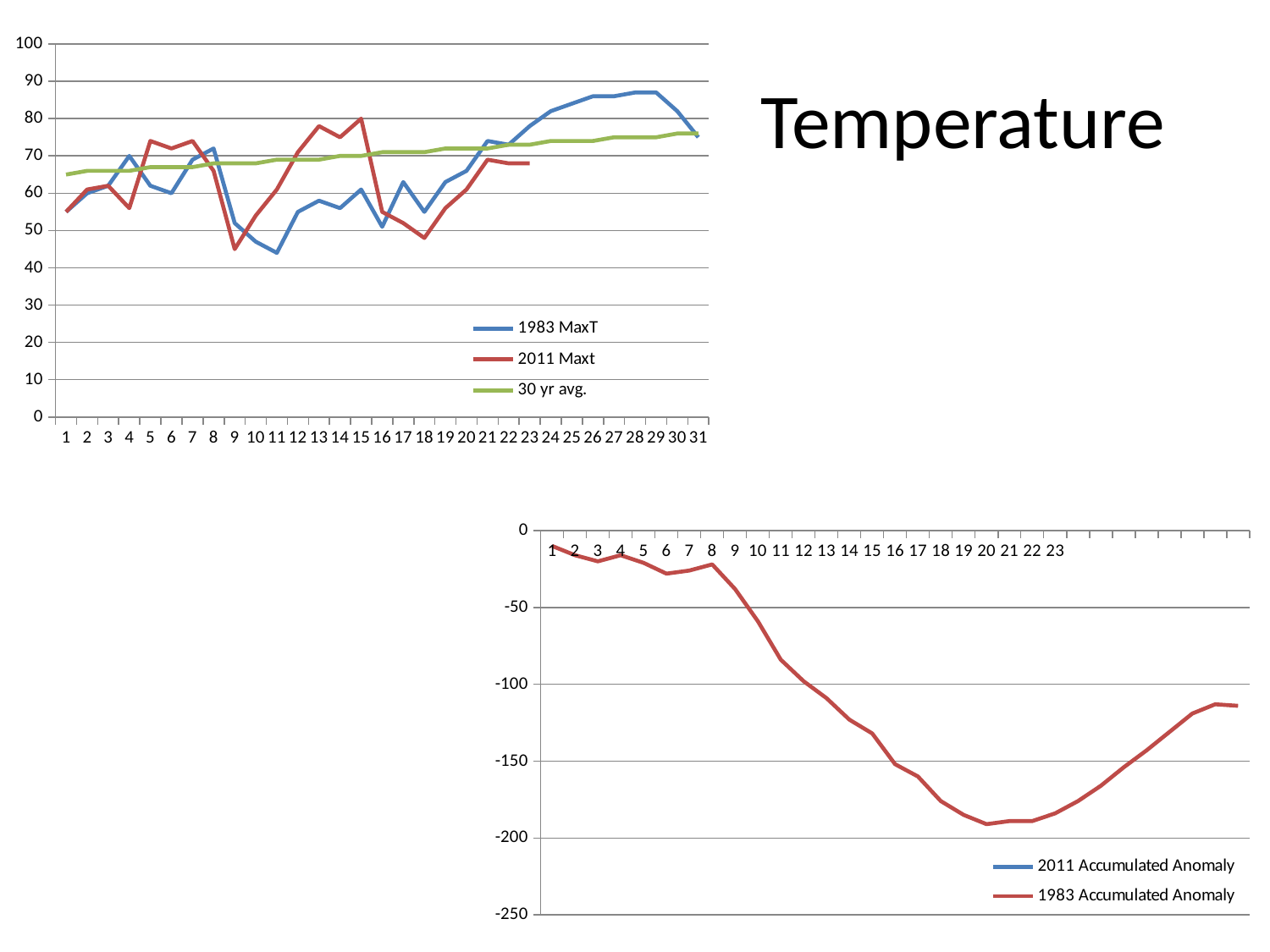
In the top-left chart, at point 15, which is larger: 2011 Maxt or 1983 MaxT? 2011 Maxt In the top-left chart, is the value for 1983 MaxT at point 11 greater or less than 50? less How many points are labelled on the x axis of the top-left chart? 31 In the top-left chart, does the 30 yr avg. series rise or fall from point 1 to point 31? rise What kind of chart is the bottom-right chart? line chart In the top-left chart, is the value for 2011 Maxt at point 9 greater or less than 50? less How many series does the legend of the top-left chart list? 3 How many series does the legend of the bottom-right chart list? 2 What kind of chart is the top-left chart? line chart In the top-left chart, is the value for 1983 MaxT at point 29 greater or less than 80? greater In the bottom-right chart, does the 1983 Accumulated Anomaly line rise or fall from point 1 to point 20? fall